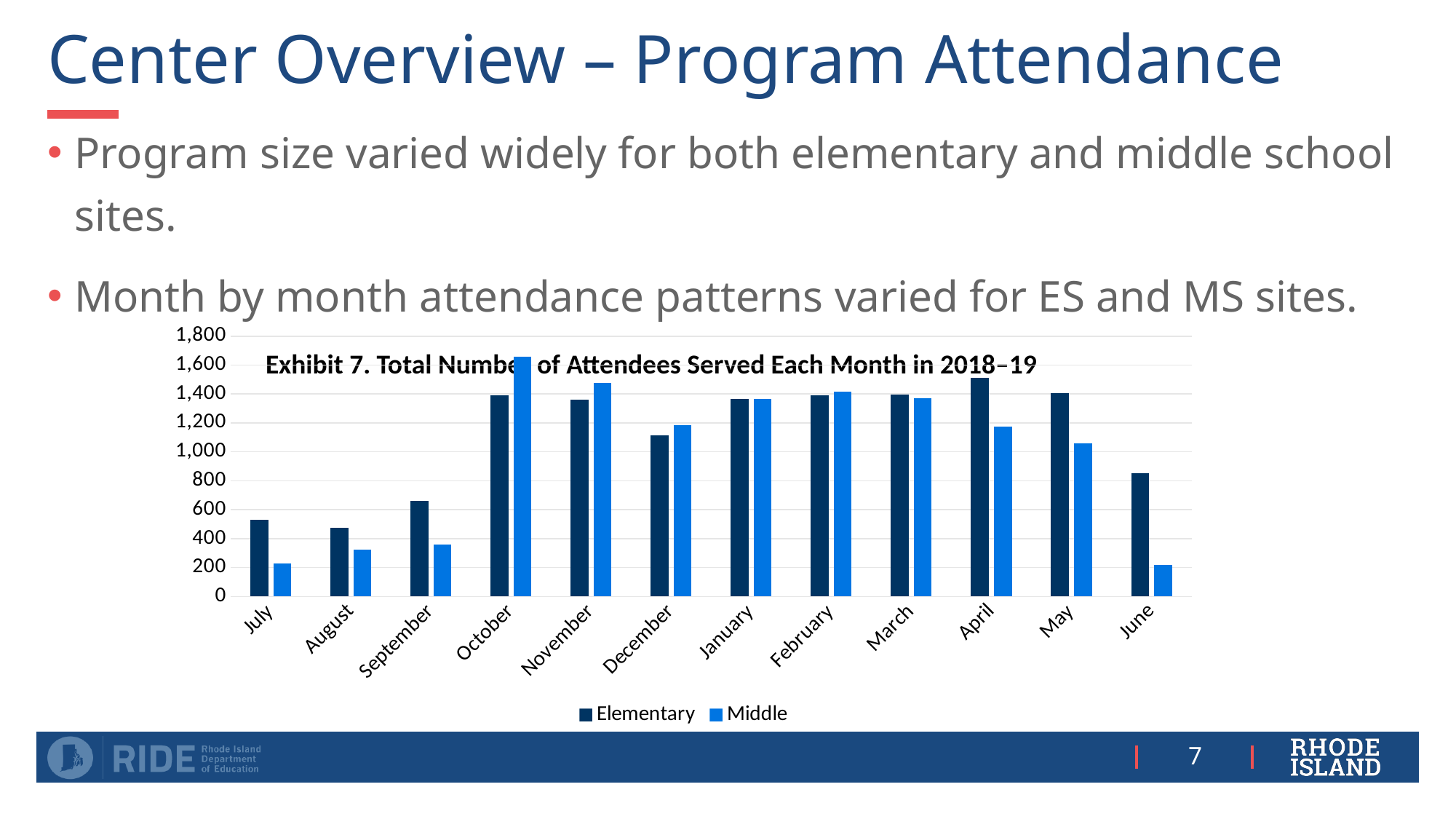
Is the Elementary value for July greater or less than 400? greater In which month is the Elementary value highest? April In May, which series has the larger value, Elementary or Middle? Elementary Is the Middle value for June greater or less than 400? less In which month is the Elementary value lowest? August What kind of chart is shown on the slide? Bar chart How many months are shown on the x axis of the chart? 12 In which month is the Middle value highest? October In October, which series has the larger value, Elementary or Middle? Middle How many series does the legend list? 2 Do the Middle values rise or fall from March through June? Fall What is the title of the chart? Exhibit 7. Total Number of Attendees Served Each Month in 2018–19